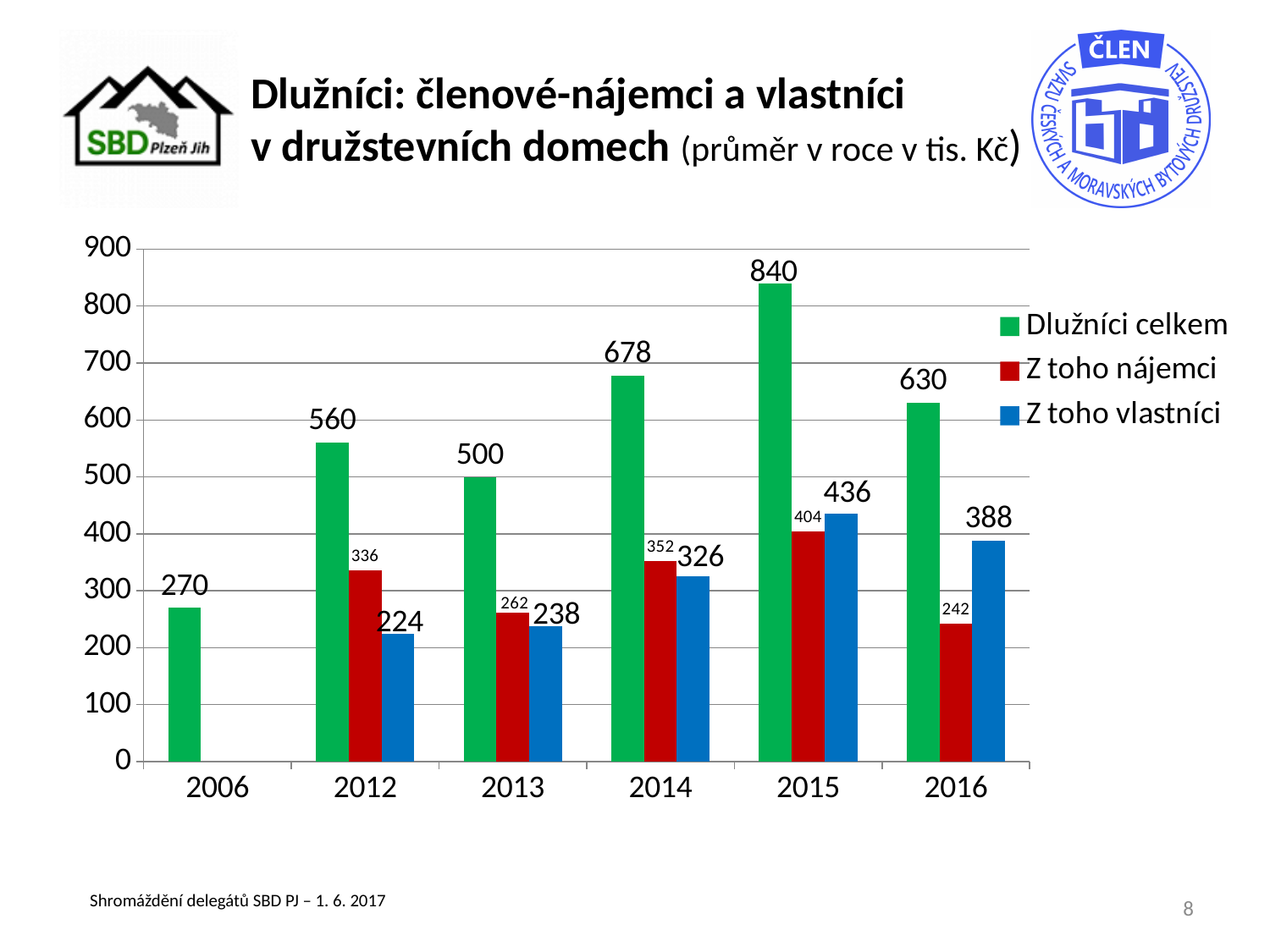
Which colour represents Z toho vlastníci in the chart? blue What is the value of Z toho vlastníci for 2016? 388 How many series does the legend list? 3 Which year has the highest value for Dlužníci celkem? 2015 What is the value of Dlužníci celkem for 2015? 840 What is the difference between Dlužníci celkem in 2015 and in 2016? 210 Which is larger in 2014: Z toho nájemci or Z toho vlastníci? Z toho nájemci What is the value of Z toho nájemci for 2012? 336 How many years are shown on the x axis? 6 Which year has the lowest value for Dlužníci celkem? 2006 What kind of chart is shown on the slide? bar chart Is the value of Dlužníci celkem for 2013 greater or less than 400? greater